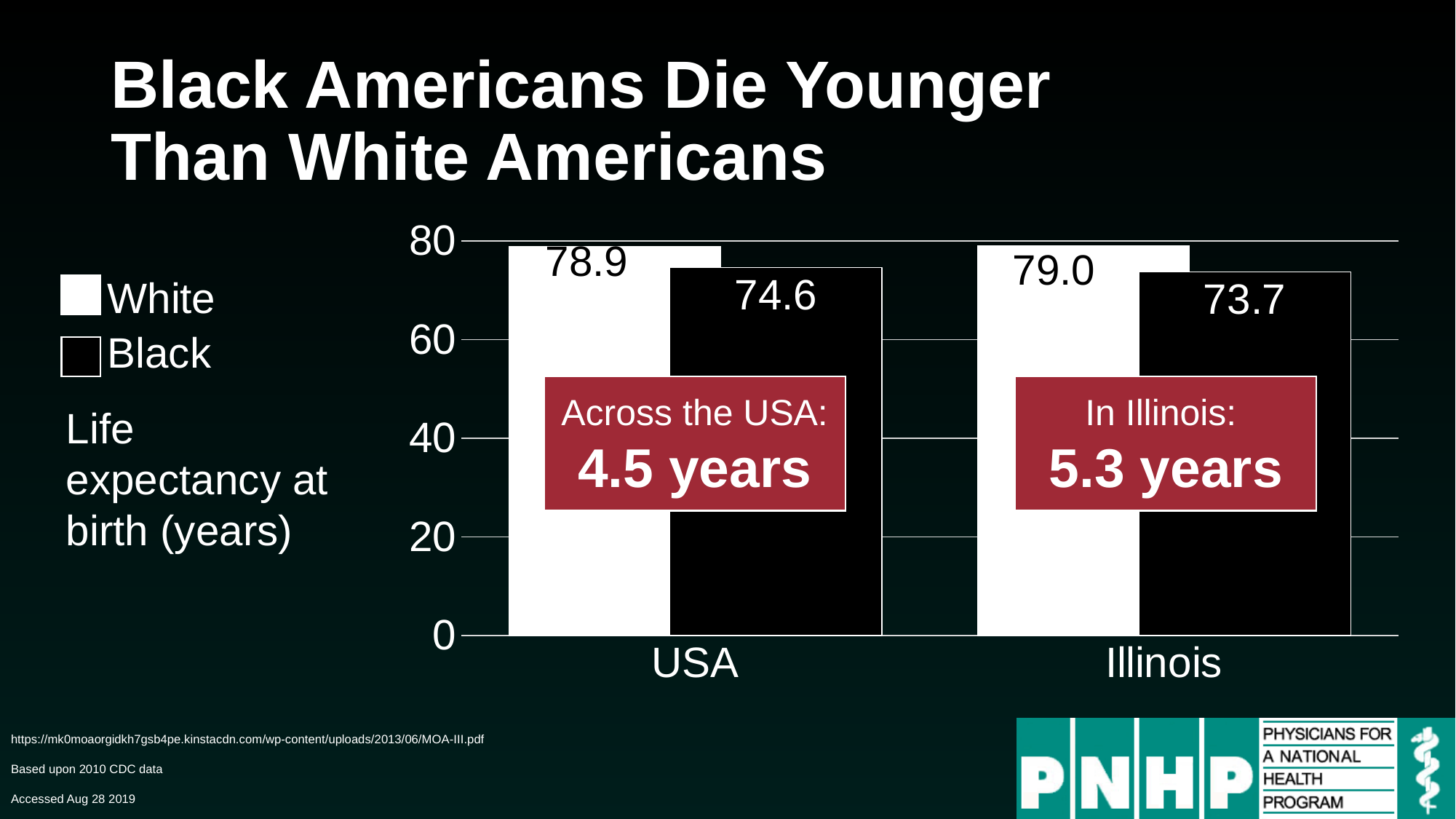
Which is larger: the life expectancy for Black Americans in the USA or in Illinois? USA What is the life expectancy at birth for Black Americans in Illinois? 73.7 What kind of chart is shown on the slide? Bar chart How many categories are shown on the x axis of the chart? 2 What is the difference in life expectancy between White and Black Americans across the USA? 4.5 years Which bar shows the lowest life expectancy on the chart? Black, Illinois What is the life expectancy at birth for White Americans in the USA? 78.9 How many series does the legend list? 2 Which colour represents the Black series in the chart? Black What is the difference in life expectancy between White and Black Americans in Illinois? 5.3 years What is the life expectancy at birth for Black Americans across the USA? 74.6 What is the life expectancy at birth for White Americans in Illinois? 79.0